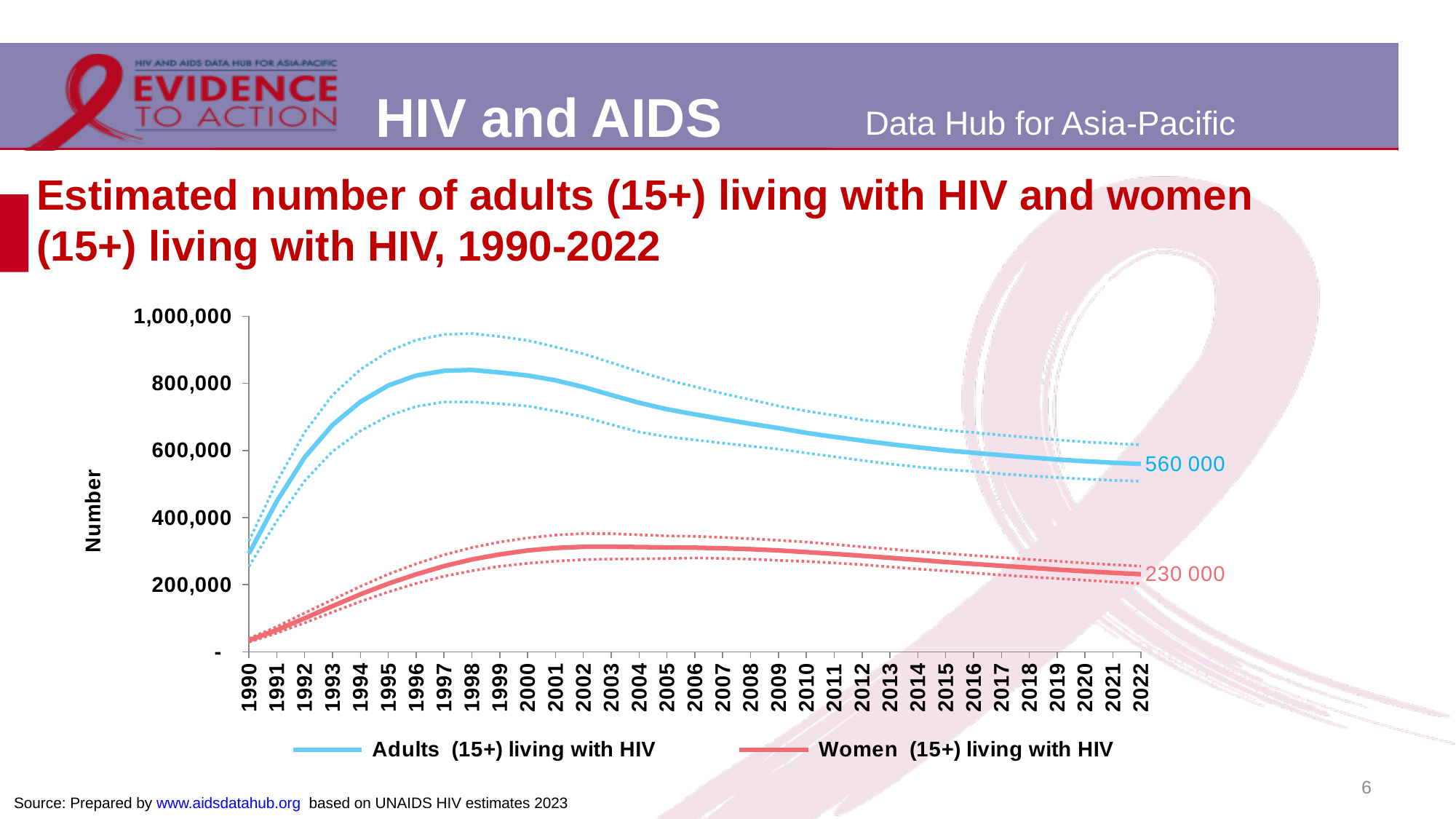
How many years are shown on the x axis? 33 What is the difference between the 2022 values for Adults (15+) living with HIV and Women (15+) living with HIV? 330 000 What is the value for Adults (15+) living with HIV in 2022? 560 000 What is the value for Women (15+) living with HIV in 2022? 230 000 Does the value for Adults (15+) living with HIV rise or fall from 1998 to 2022? Fall What is the label on the y axis? Number Is the value for Women (15+) living with HIV in 1990 greater or less than 200,000? less Is the value for Adults (15+) living with HIV in 1990 greater or less than 400,000? less Is the value for Adults (15+) living with HIV in 1998 greater or less than 800,000? greater In 2022, which series has the larger value: Adults (15+) living with HIV or Women (15+) living with HIV? Adults (15+) living with HIV How many series does the legend list? 2 What kind of chart is shown on the slide? Line chart